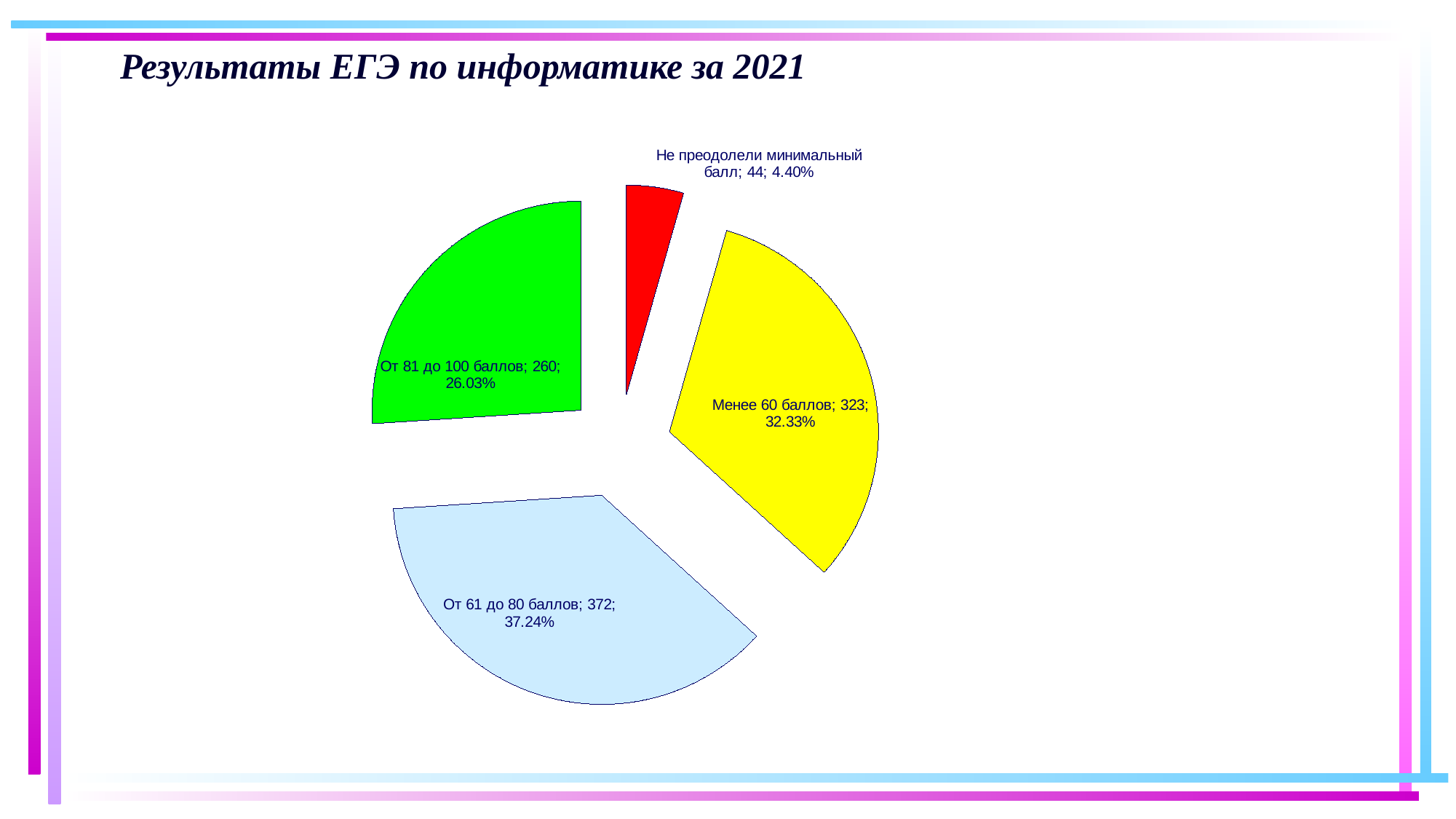
What is the value for "Менее 60 баллов"? 323 What share of the pie does "Не преодолели минимальный балл" represent? 4.40% What kind of chart is shown on the slide? pie chart How many slices does the pie chart have? 4 What is the value for "От 61 до 80 баллов"? 372 What is the difference between the values for "От 61 до 80 баллов" and "Менее 60 баллов"? 49 Which category has the largest slice? От 61 до 80 баллов Which is larger: the value for "Менее 60 баллов" or "От 81 до 100 баллов"? Менее 60 баллов What share of the pie does "От 81 до 100 баллов" represent? 26.03% What is the value for "Не преодолели минимальный балл"? 44 What colour is the slice for "Менее 60 баллов"? yellow Which category has the smallest slice? Не преодолели минимальный балл